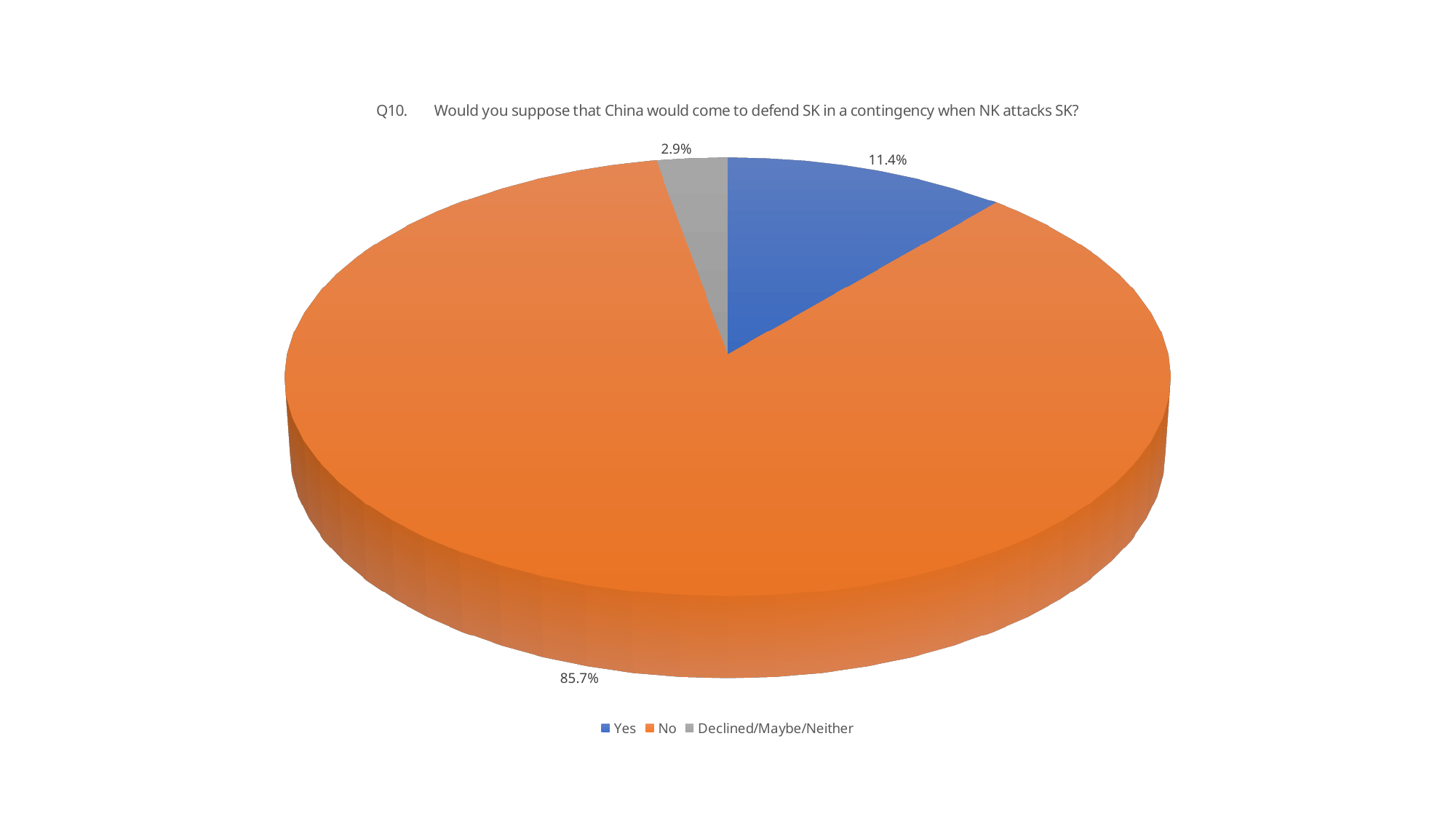
Which response has the largest share of the pie? No How many slices does the pie chart have? 3 How many entries does the legend list? 3 Which response has the smallest share of the pie? Declined/Maybe/Neither Which is larger, the share for "Yes" or the share for "Declined/Maybe/Neither"? Yes What percentage of respondents answered "Declined/Maybe/Neither"? 2.9% What percentage of respondents answered "No"? 85.7% What percentage of respondents answered "Yes"? 11.4% What is the title of the chart? Q10. Would you suppose that China would come to defend SK in a contingency when NK attacks SK? What kind of chart is shown on the slide? Pie chart What colour is the slice representing "No"? Orange What is the difference in percentage points between the "No" share and the "Yes" share? 74.3